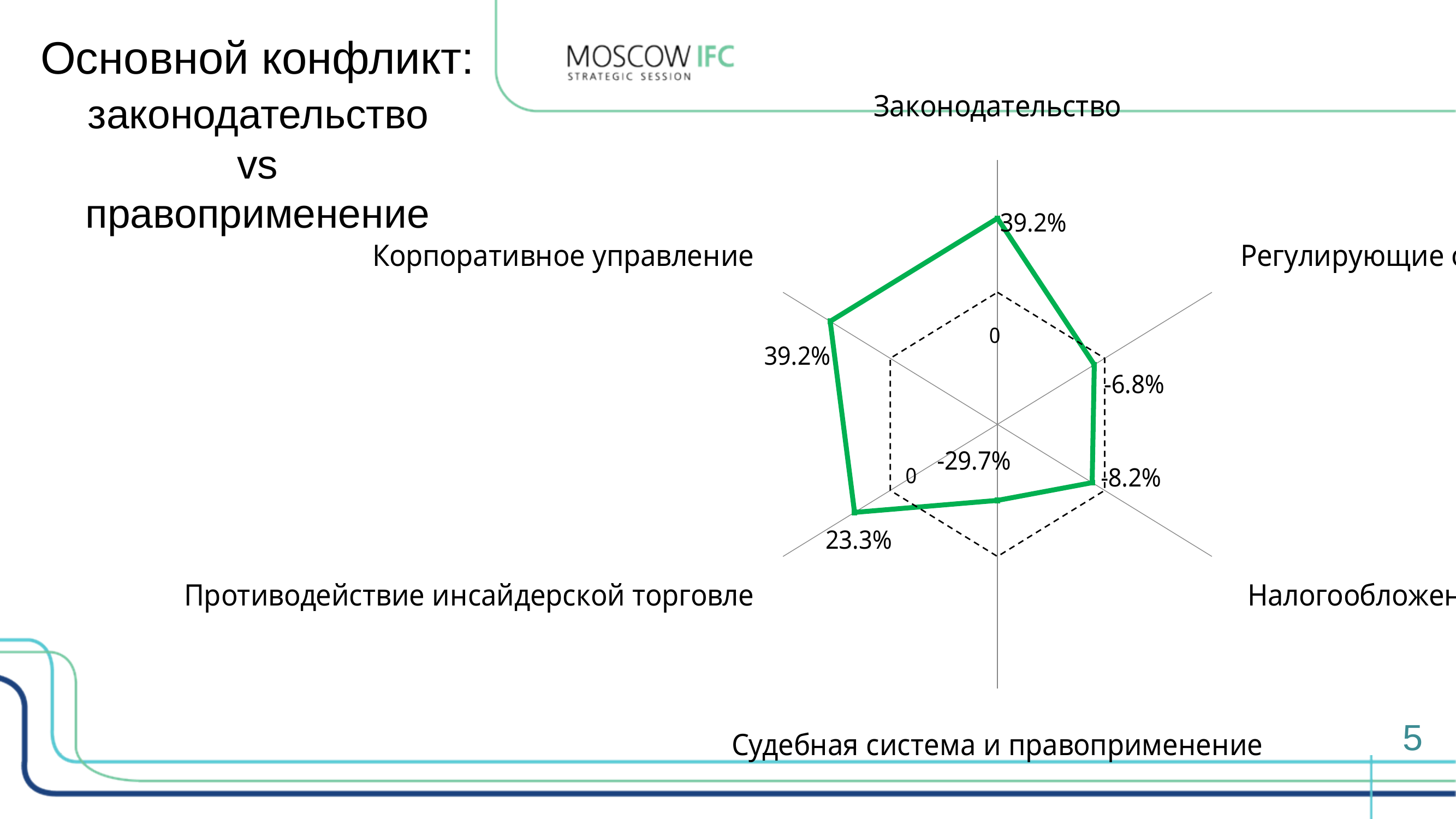
What is the value for Судебная система и правоприменение? -29.7% What is the value for Противодействие инсайдерской торговле? 23.3% What is the difference between the values for Корпоративное управление and Противодействие инсайдерской торговле? 15.9% How many axes (categories) does the radar chart have? 6 What is the value for Законодательство? 39.2% What colour is the solid data line on the radar chart? Green What is the value for Корпоративное управление? 39.2% Which category has the lowest value? Судебная система и правоприменение What kind of chart is shown on the slide? Radar chart Is the value for Судебная система и правоприменение greater or less than 0? less Which is larger: the value for Противодействие инсайдерской торговле or the value for Судебная система и правоприменение? Противодействие инсайдерской торговле What is the difference between the values for Законодательство and Судебная система и правоприменение? 68.9%